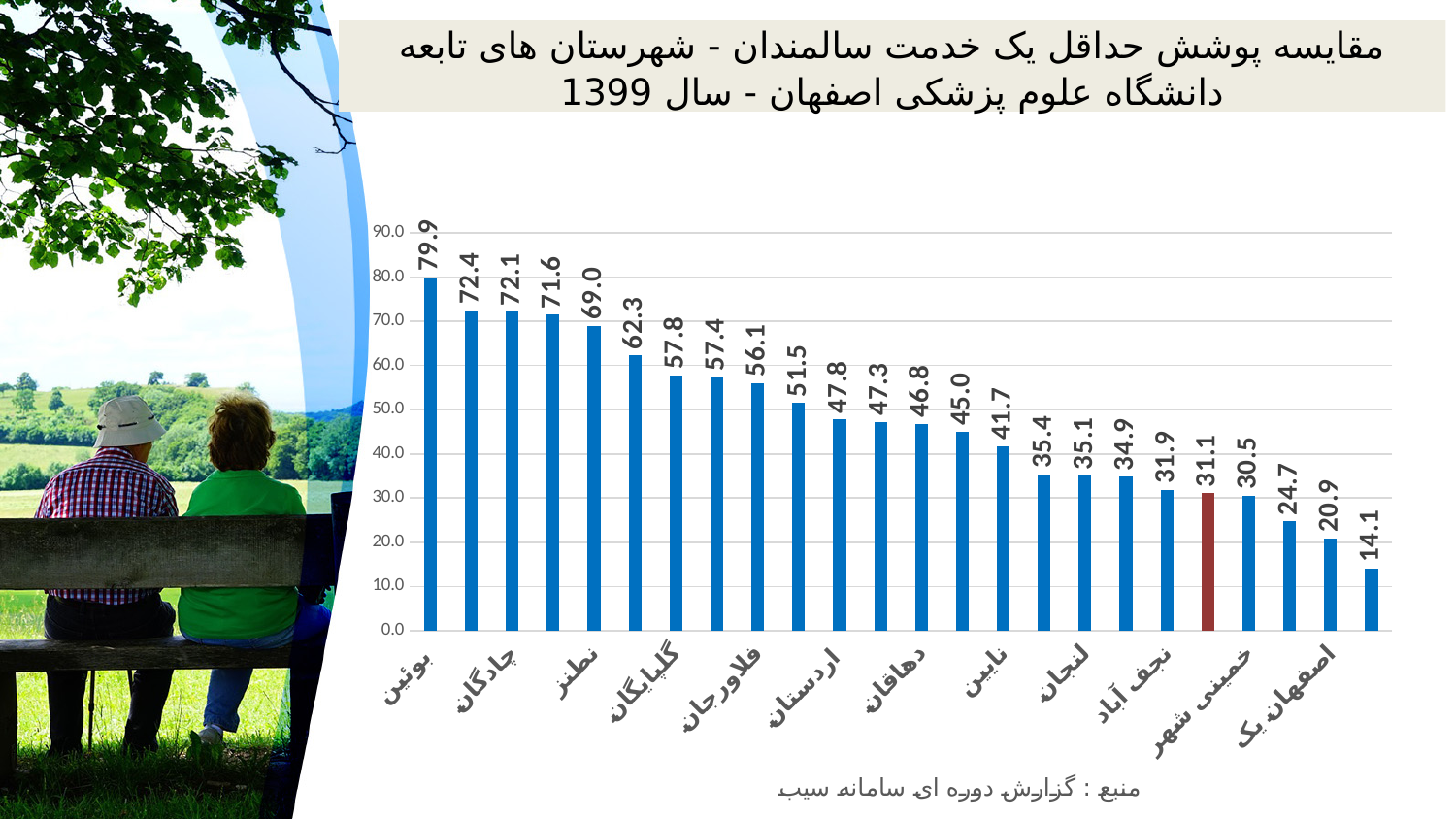
What is the difference between the highest value (79.9) and the lowest value (14.1)? 65.8 Which is larger, the value of the first bar (79.9) or the value of the red bar (31.1)? 79.9 How many bars are plotted in the chart? 24 What type of chart is shown on the slide? bar chart What is the maximum value shown on the vertical axis? 90.0 Do the bar values rise or fall from left to right along the x axis? fall What is the value for بوئین? 79.9 What is the value of the red (highlighted) bar in the chart? 31.1 Is the value for بوئین greater or less than 70? greater Which category has the highest value in the chart? بوئین What is the lowest value shown in the chart? 14.1 What is the highest value shown in the chart? 79.9